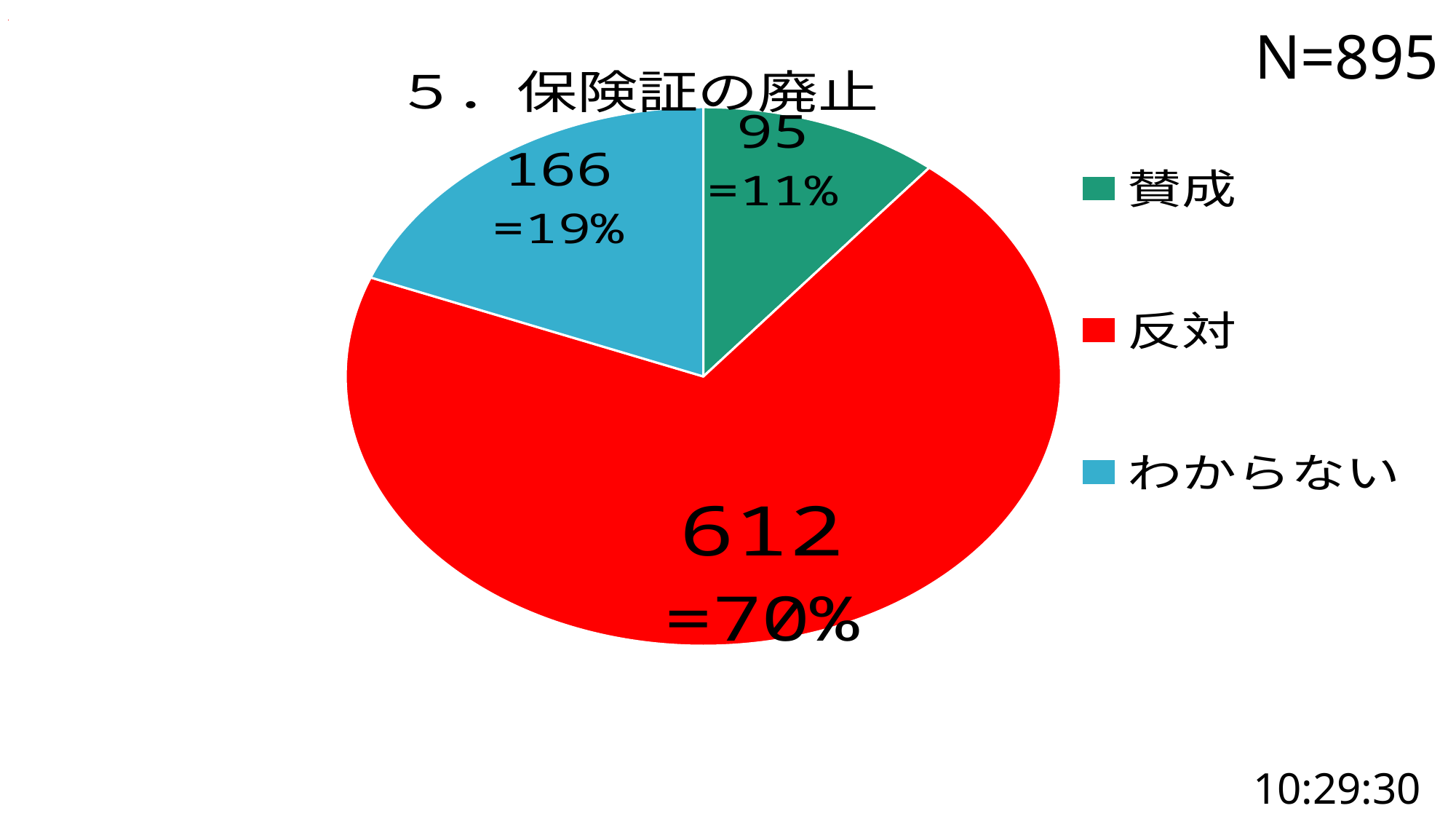
Which is larger, the value for わからない or the value for 賛成? わからない What is the difference between the values for 反対 and わからない? 446 What is the value for わからない? 166 Which category has the largest slice? 反対 What is the value for 反対? 612 What kind of chart is shown on the slide? pie chart What share of the pie does わからない represent? 19% How many categories does the legend list? 3 What is the value for 賛成? 95 Which category has the smallest slice? 賛成 What share of the pie does 賛成 represent? 11% What share of the pie does 反対 represent? 70%